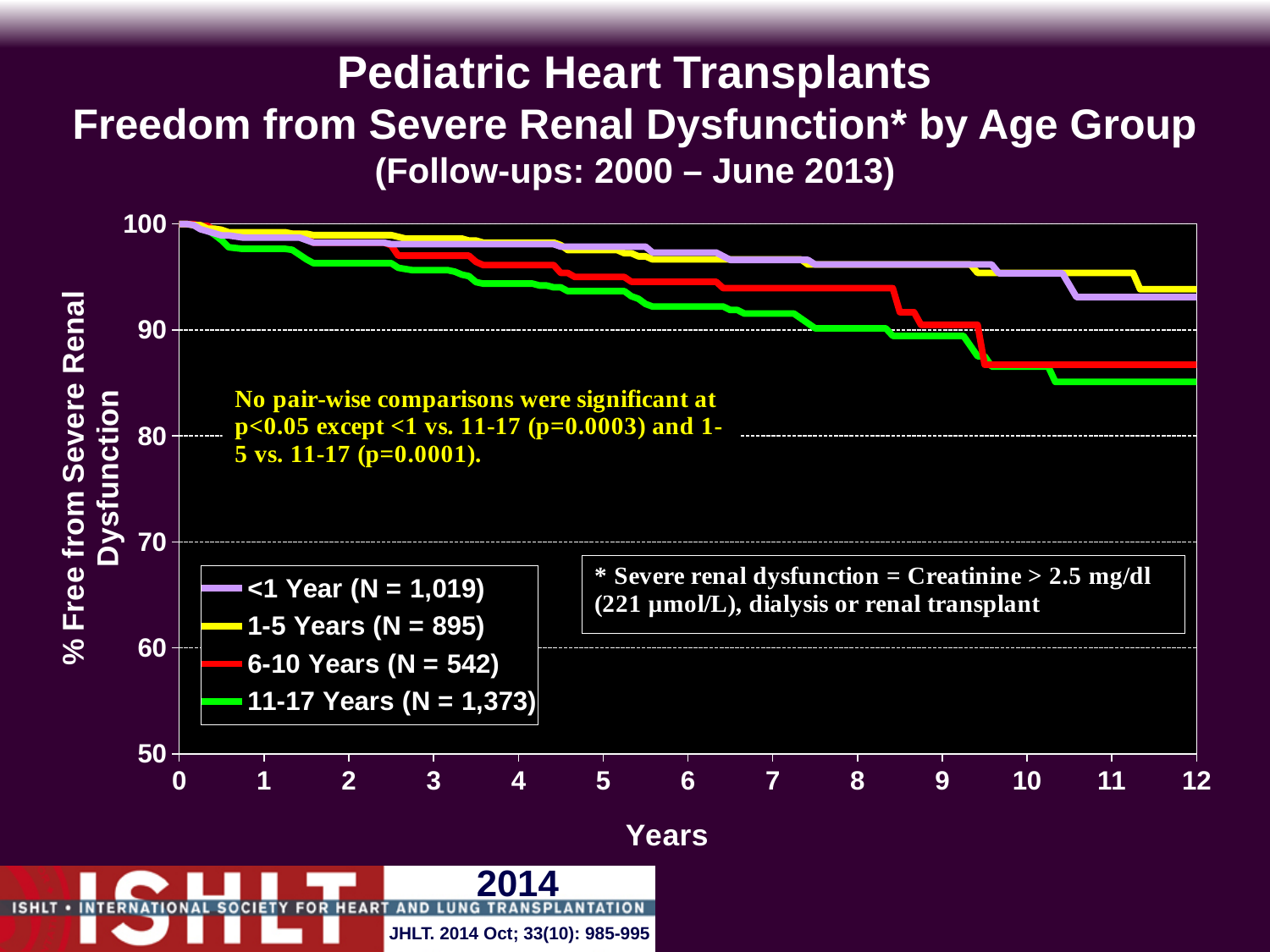
Is the value for the 1-5 Years group at 6 years greater or less than 90? greater What kind of chart is shown on the slide? line chart Is the value for the 6-10 Years group at 12 years greater or less than 90? less Which age group has the largest N in the legend? 11-17 Years (N = 1,373) At 12 years, which is higher: the <1 Year group or the 11-17 Years group? <1 Year What is the % free from severe renal dysfunction for all groups at year 0? 100 Do the values for the 11-17 Years group rise or fall as years increase? fall What is the N for the 6-10 Years group shown in the legend? 542 How many series does the legend list? 4 At 12 years, which is higher: the 1-5 Years group or the 6-10 Years group? 1-5 Years Is the value for the 11-17 Years group at 12 years greater or less than 90? less